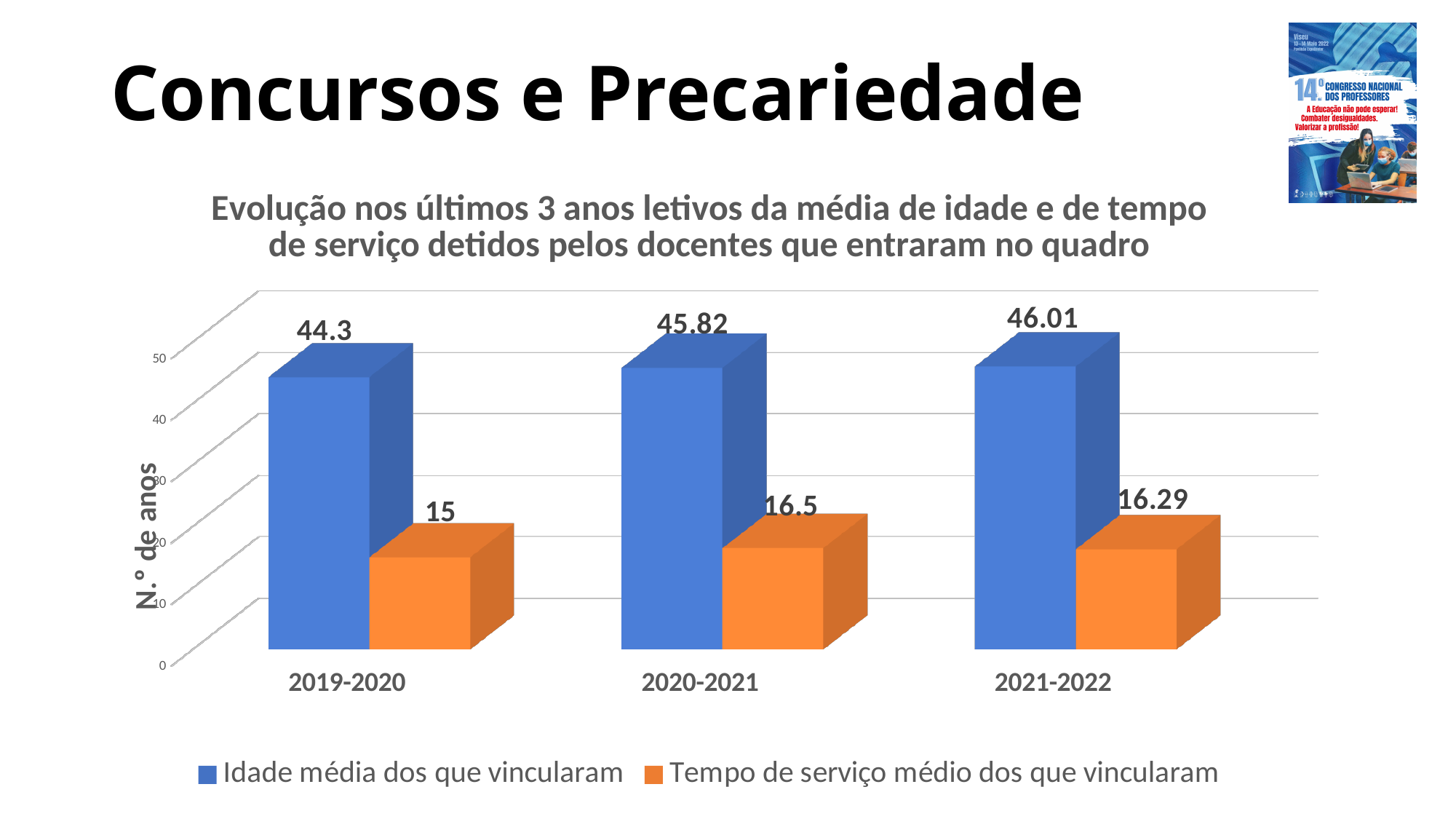
What is the value of 'Idade média dos que vincularam' for 2019-2020? 44.3 What is the label of the vertical axis? N.º de anos How many series does the legend list? 2 What is the value of 'Tempo de serviço médio dos que vincularam' for 2020-2021? 16.5 In which school year is 'Idade média dos que vincularam' highest? 2021-2022 What is the value of 'Tempo de serviço médio dos que vincularam' for 2021-2022? 16.29 Which is larger: 'Tempo de serviço médio dos que vincularam' in 2020-2021 or in 2021-2022? 2020-2021 What kind of chart is shown on the slide? Bar chart In which school year is 'Tempo de serviço médio dos que vincularam' lowest? 2019-2020 What is the difference between 'Idade média dos que vincularam' in 2021-2022 and in 2019-2020? 1.71 What is the value of 'Idade média dos que vincularam' for 2021-2022? 46.01 How many school years are shown on the x axis? 3